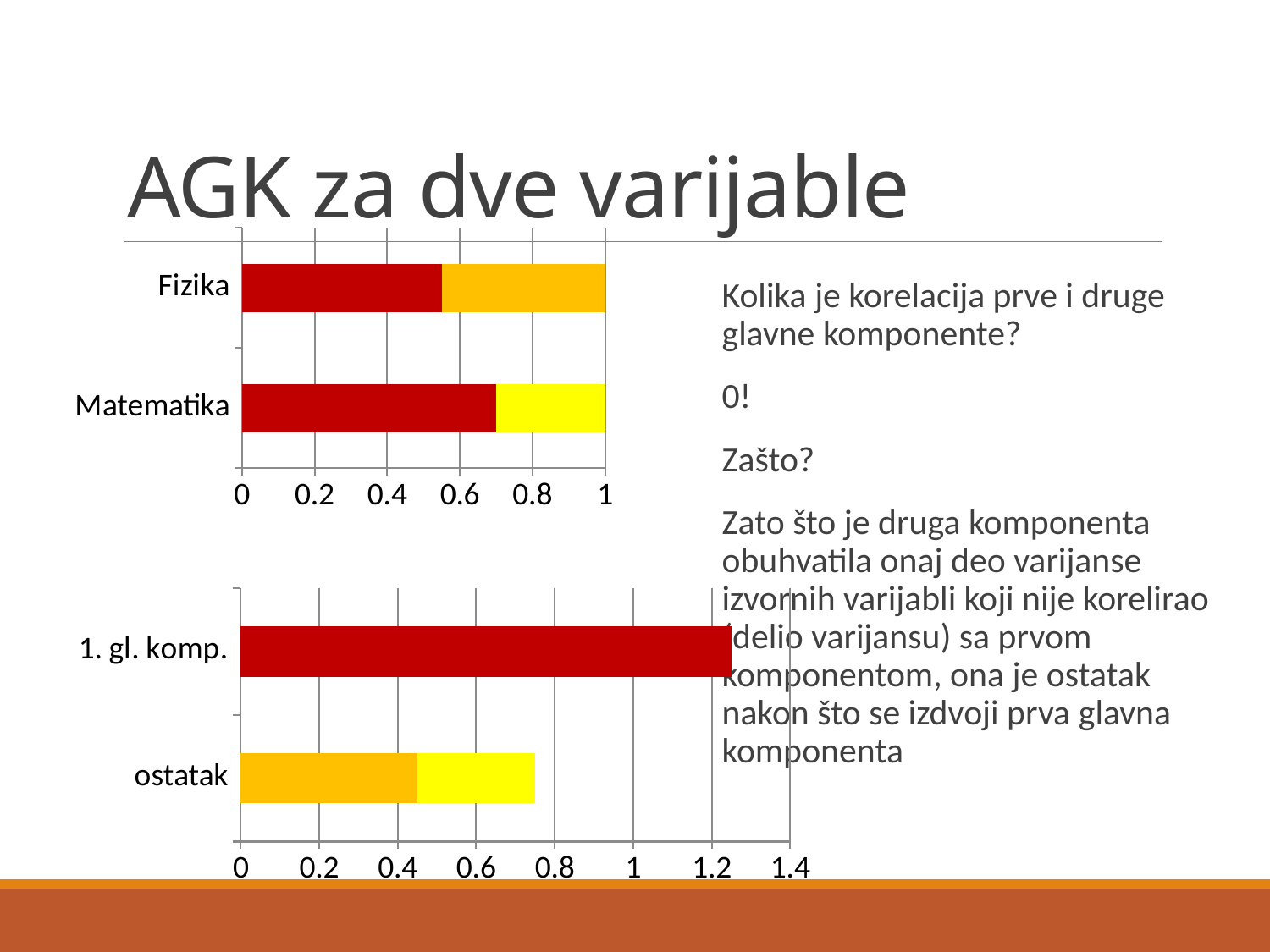
In the top chart, what is the total length of the stacked bar for Matematika? 1 In the bottom chart, what is the highest value shown on the x axis? 1.4 In the bottom chart, is the total value for ostatak greater or less than 0.6? greater In the top chart, is the red segment for Matematika greater or less than 0.6? greater In the top chart, which category has the longer red segment, Fizika or Matematika? Matematika In the top chart, what is the total length of the stacked bar for Fizika? 1 How many categories does the top chart show? 2 In the bottom chart, which category has the longest bar? 1. gl. komp. How many categories does the bottom chart show? 2 In the bottom chart, which category has the shortest bar? ostatak In the bottom chart, is the value for 1. gl. komp. greater or less than 1? greater What kind of chart is the top chart on the slide? bar chart